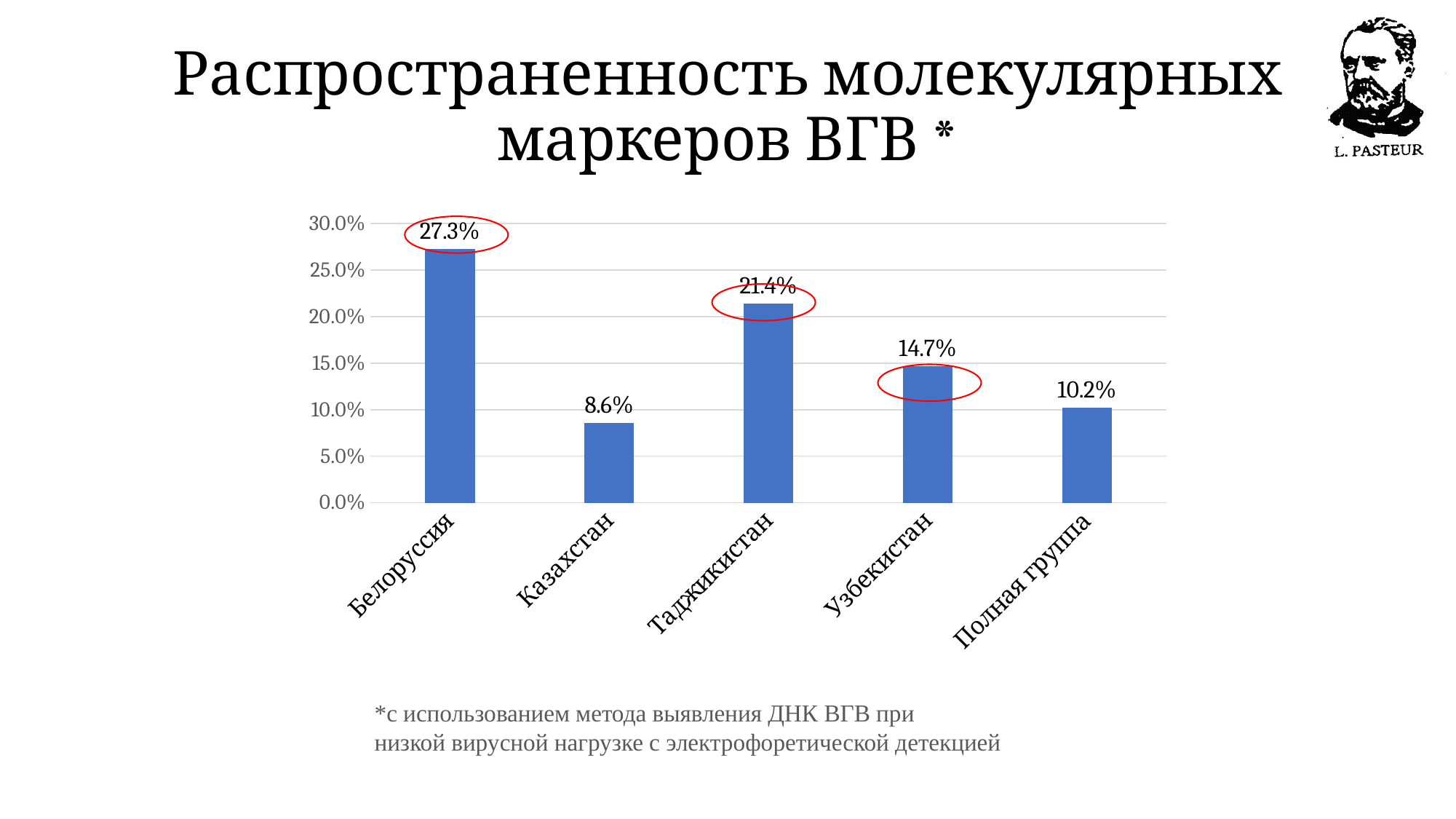
Is the value for Таджикистан greater or less than 20.0%? greater Which category has the highest value? Белоруссия What is the value for Белоруссия? 27.3% What is the value for Казахстан? 8.6% What is the difference between the values for Белоруссия and Таджикистан? 5.9% What kind of chart is shown on the slide? bar chart How many categories are shown on the x axis? 5 Which category has the lowest value? Казахстан What is the value for Полная группа? 10.2% Which is larger, the value for Узбекистан or the value for Полная группа? Узбекистан What is the value for Узбекистан? 14.7% What is the value for Таджикистан? 21.4%